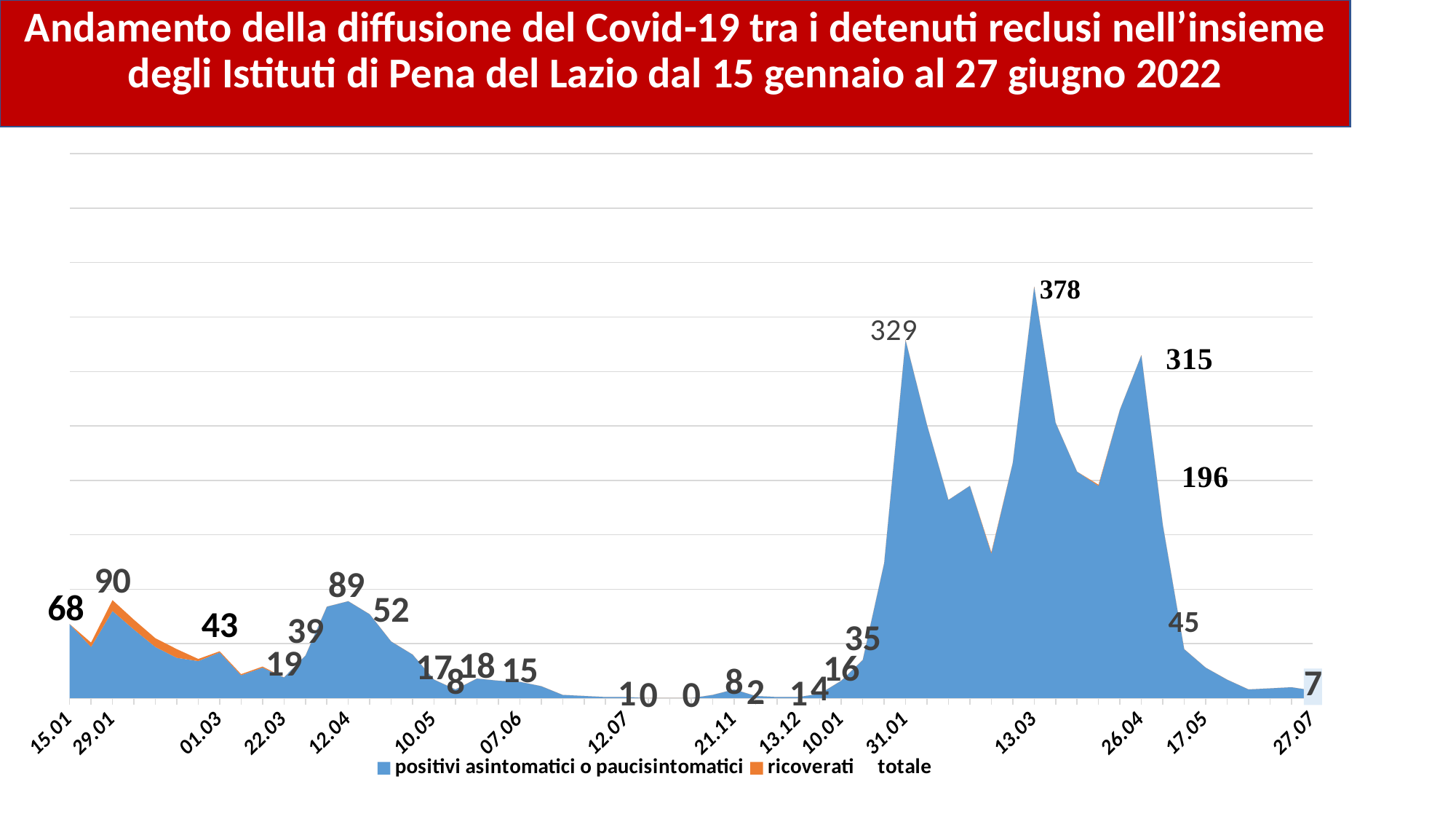
What is the value labelled at 12.04? 89 Which is larger, the value at 31.01 (329) or the later peak labelled 315? 329 What kind of chart is shown on the slide? Area chart What is the lowest value labelled on the chart? 0 Do the values rise or fall from 26.04 to 27.07? Fall What is the difference between the peak value 378 and the value 329 at 31.01? 49 What is the value at the last point, 27.07? 7 What is the highest value labelled on the chart? 378 How many series does the legend list? 3 Is the value at 13.03 greater or less than 300? greater What is the value labelled at 31.01? 329 What is the value at the first point, 15.01? 68